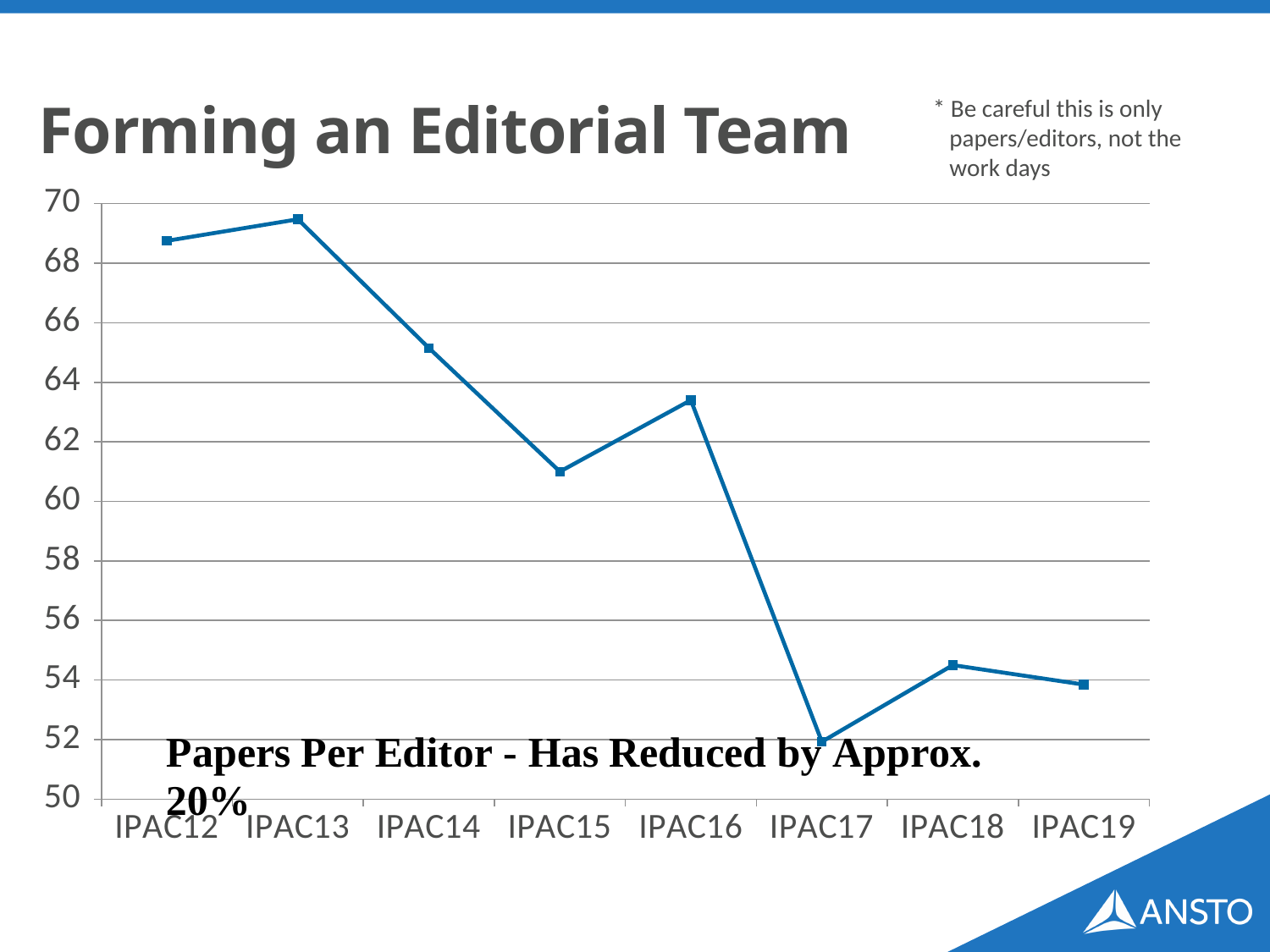
Which conference has the highest papers-per-editor value? IPAC13 How many IPAC conferences are plotted on the x axis? 8 Is the value for IPAC16 greater or less than 64? less Which conference has the lowest papers-per-editor value? IPAC17 Is the value for IPAC17 greater or less than 54? less What is the text label shown inside the chart area? Papers Per Editor - Has Reduced by Approx. 20% Which is larger, the value for IPAC15 or IPAC16? IPAC16 What kind of chart is shown on the slide? line chart Is the value for IPAC12 greater or less than 68? greater Do the values generally rise or fall from IPAC12 to IPAC19? fall